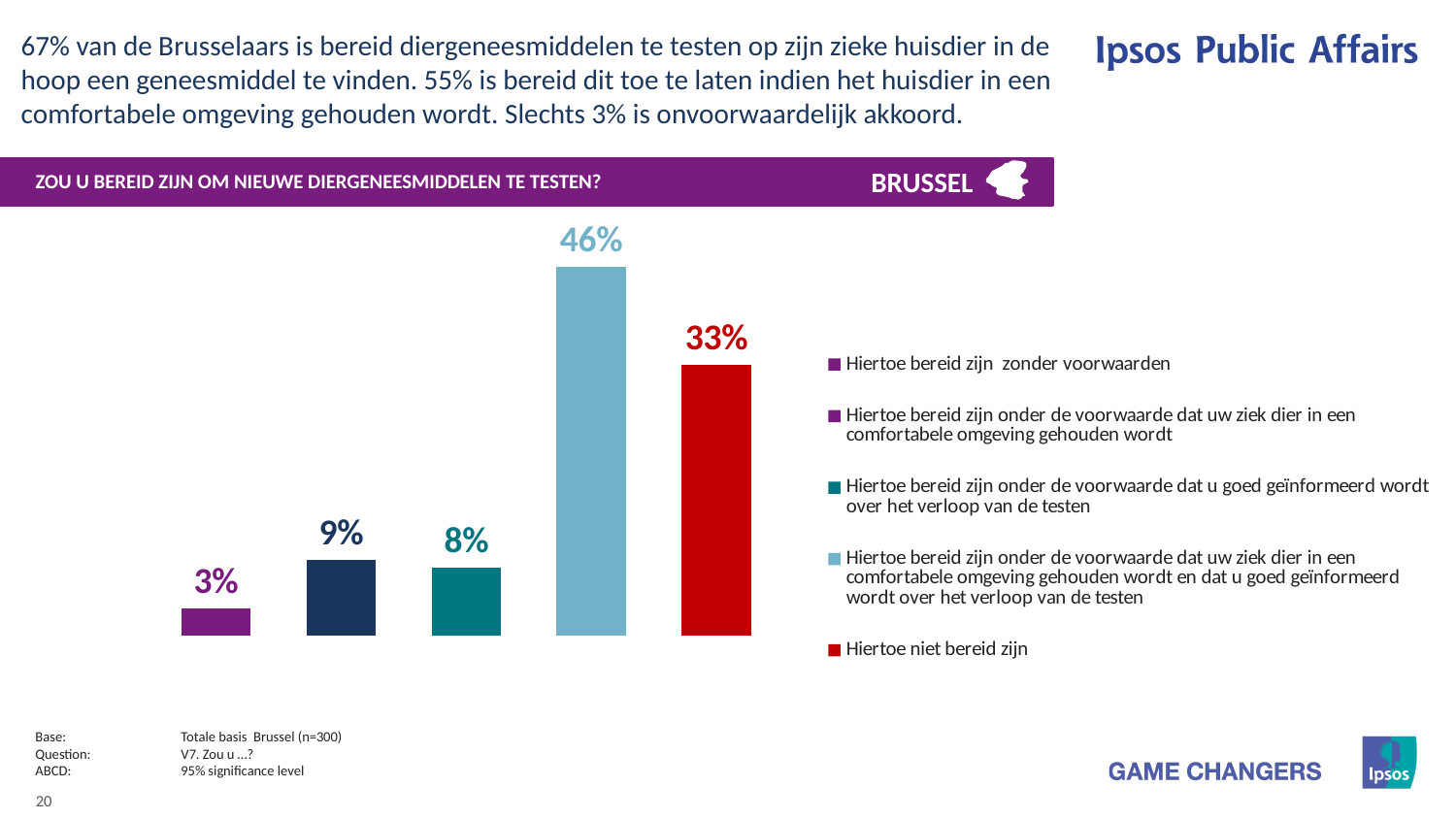
What percentage is shown for the condition that the sick animal is kept in a comfortable environment and the respondent is well informed about the course of the tests? 46% Which is larger: the value for "Hiertoe bereid zijn onder de voorwaarde dat uw ziek dier in een comfortabele omgeving gehouden wordt" or the value for "Hiertoe bereid zijn onder de voorwaarde dat u goed geïnformeerd wordt over het verloop van de testen"? Hiertoe bereid zijn onder de voorwaarde dat uw ziek dier in een comfortabele omgeving gehouden wordt (9%) What value is shown for "Hiertoe niet bereid zijn"? 33% What colour is the bar for "Hiertoe niet bereid zijn"? Red Which legend category has the highest value in the chart? Hiertoe bereid zijn onder de voorwaarde dat uw ziek dier in een comfortabele omgeving gehouden wordt en dat u goed geïnformeerd wordt over het verloop van de testen Which legend category has the lowest value in the chart? Hiertoe bereid zijn zonder voorwaarden How many entries does the legend list? 5 What type of chart is shown on the slide? Bar chart What value is shown for the bar "Hiertoe bereid zijn onder de voorwaarde dat u goed geïnformeerd wordt over het verloop van de testen"? 8% How many bars are plotted in the chart? 5 What is the difference between the highest bar (46%) and the "Hiertoe niet bereid zijn" bar (33%)? 13 percentage points What percentage of respondents are willing to test new veterinary medicines without conditions ("Hiertoe bereid zijn zonder voorwaarden")? 3%